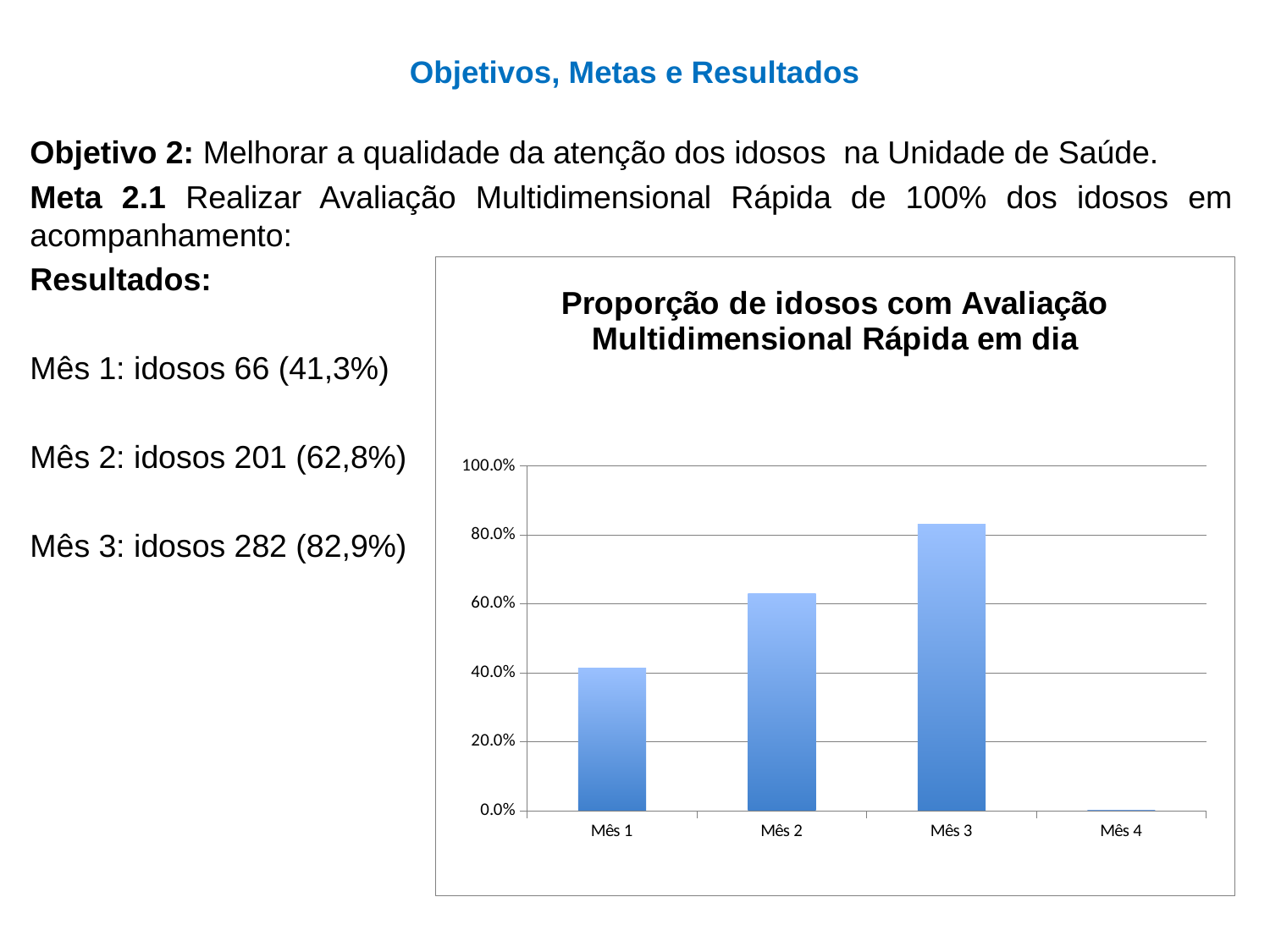
Which category has the lowest bar in the chart? Mês 4 Which is larger, the value for Mês 1 or the value for Mês 2? Mês 2 Is the value for Mês 3 greater or less than 100.0%? less Which category has the highest bar in the chart? Mês 3 Is the value for Mês 1 greater or less than 60.0%? less Do the values rise or fall from Mês 1 to Mês 3? rise What kind of chart is shown on the slide? bar chart Is the value for Mês 1 greater or less than 20.0%? greater What is the title of the chart? Proporção de idosos com Avaliação Multidimensional Rápida em dia How many categories are shown on the x axis of the chart? 4